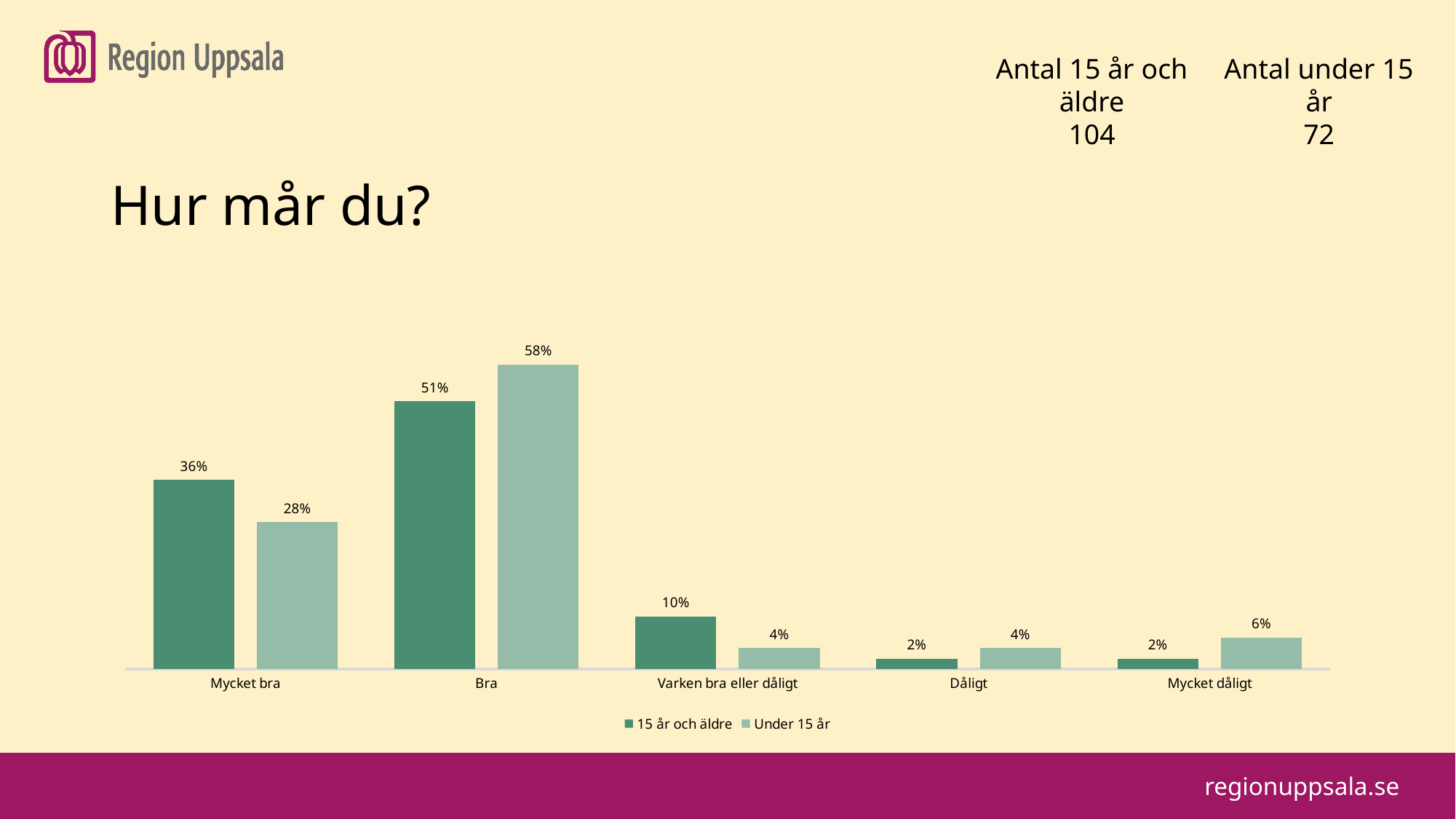
Which category has the highest value in the "Under 15 år" series? Bra What is the total of the two series' values for "Mycket dåligt"? 8% What is the value for "Bra" in the "15 år och äldre" series? 51% Which category has the lowest value in the "Under 15 år" series? Varken bra eller dåligt and Dåligt (tied at 4%) What is the difference between the "Under 15 år" and "15 år och äldre" values for "Bra"? 7% What is the title of the slide above the chart? Hur mår du? What is the value for "Varken bra eller dåligt" in the "15 år och äldre" series? 10% How many series does the legend list? 2 How many categories are shown on the x axis? 5 What kind of chart is shown on the slide? Bar chart For "Mycket bra", which series has the larger value: "15 år och äldre" or "Under 15 år"? 15 år och äldre What is the value for "Mycket bra" in the "Under 15 år" series? 28%